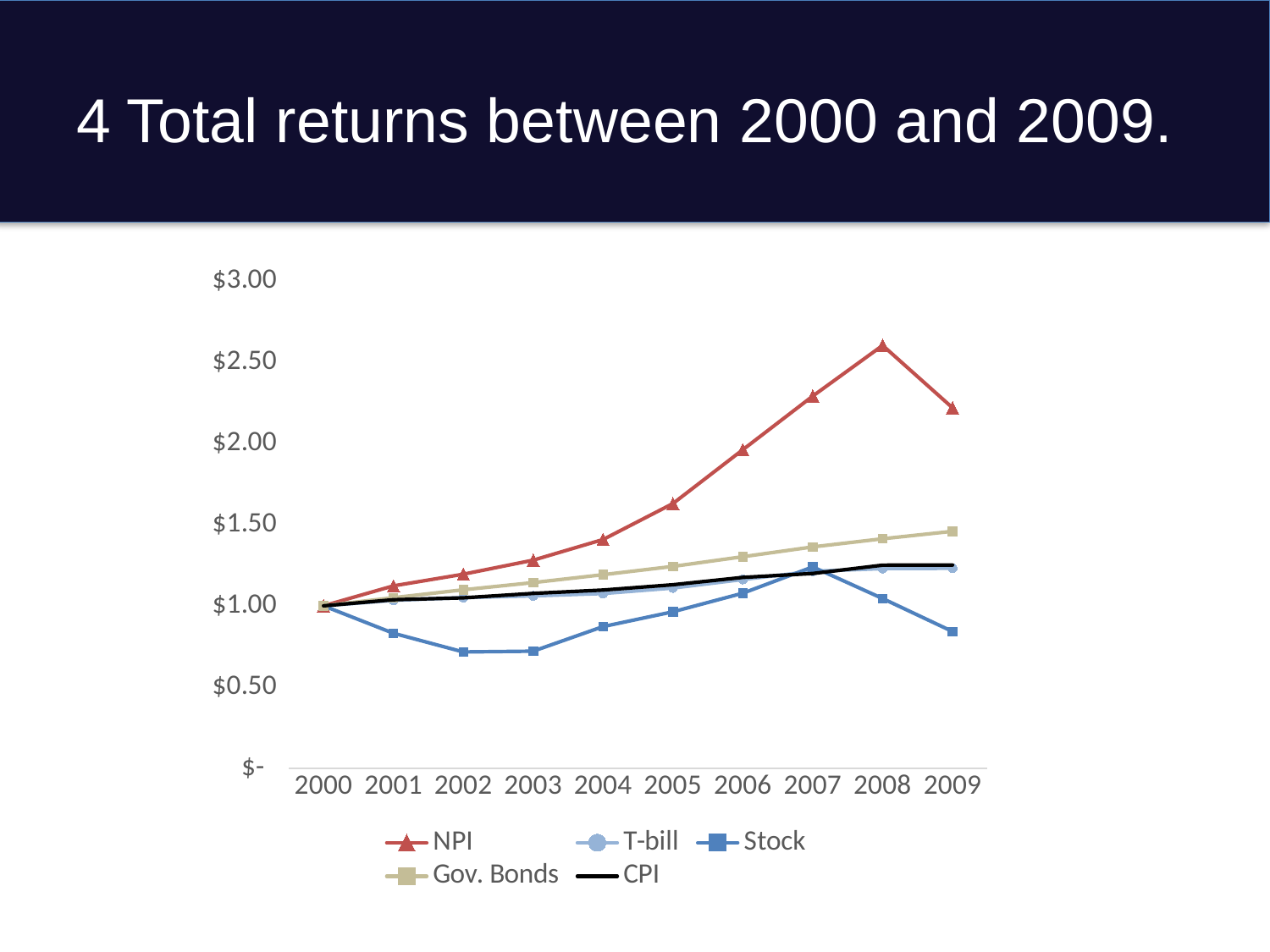
How many years are shown along the x axis? 10 How many series does the legend list? 5 Does the NPI series rise or fall between 2000 and 2008? rise Is the value for NPI in 2009 greater or less than $2.50? less What kind of chart is shown on the slide? line chart Which is larger in 2007, the value for NPI or the value for Stock? NPI Is the value for NPI in 2006 greater or less than $1.50? greater Is the value for Stock in 2002 greater or less than $1.00? less Which series has the highest value in 2008? NPI What is the title of the slide? 4 Total returns between 2000 and 2009. Which series has the lowest value in 2009? Stock